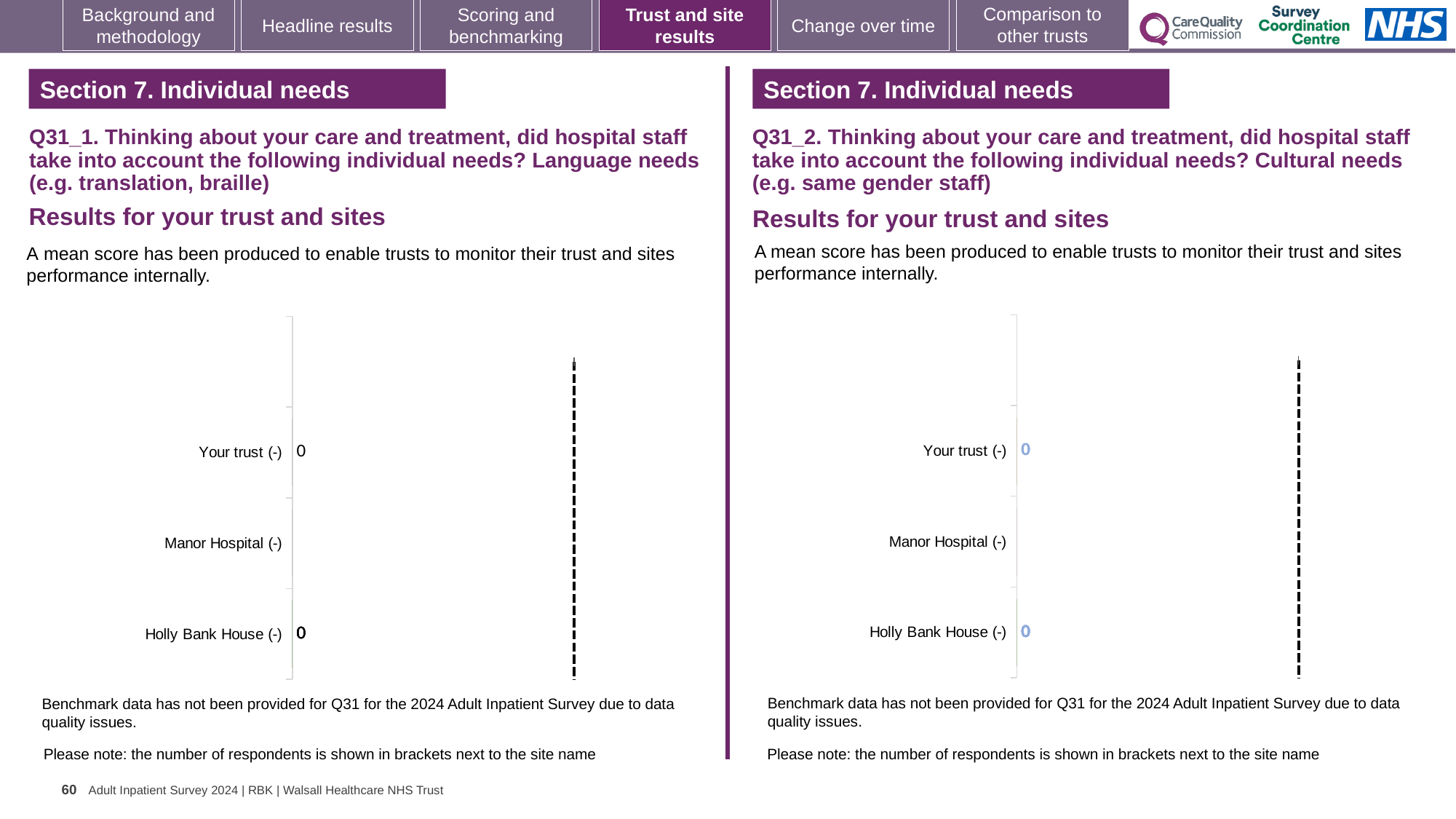
On the left chart (Q31_1, Language needs), what value is shown for Your trust (-)? 0 How many categories are listed on the right chart (Q31_2, Cultural needs)? 3 Which section do both charts on the slide belong to? Section 7. Individual needs On the right chart (Q31_2, Cultural needs), what value is shown for Holly Bank House (-)? 0 How many categories are listed on the left chart (Q31_1, Language needs)? 3 On the right chart (Q31_2, Cultural needs), what value is shown for Your trust (-)? 0 On the left chart (Q31_1, Language needs), which category has no value label shown? Manor Hospital (-) What kind of chart is the left chart (Q31_1, Language needs)? Bar chart What kind of chart is the right chart (Q31_2, Cultural needs)? Bar chart On the left chart (Q31_1, Language needs), what value is shown for Holly Bank House (-)? 0